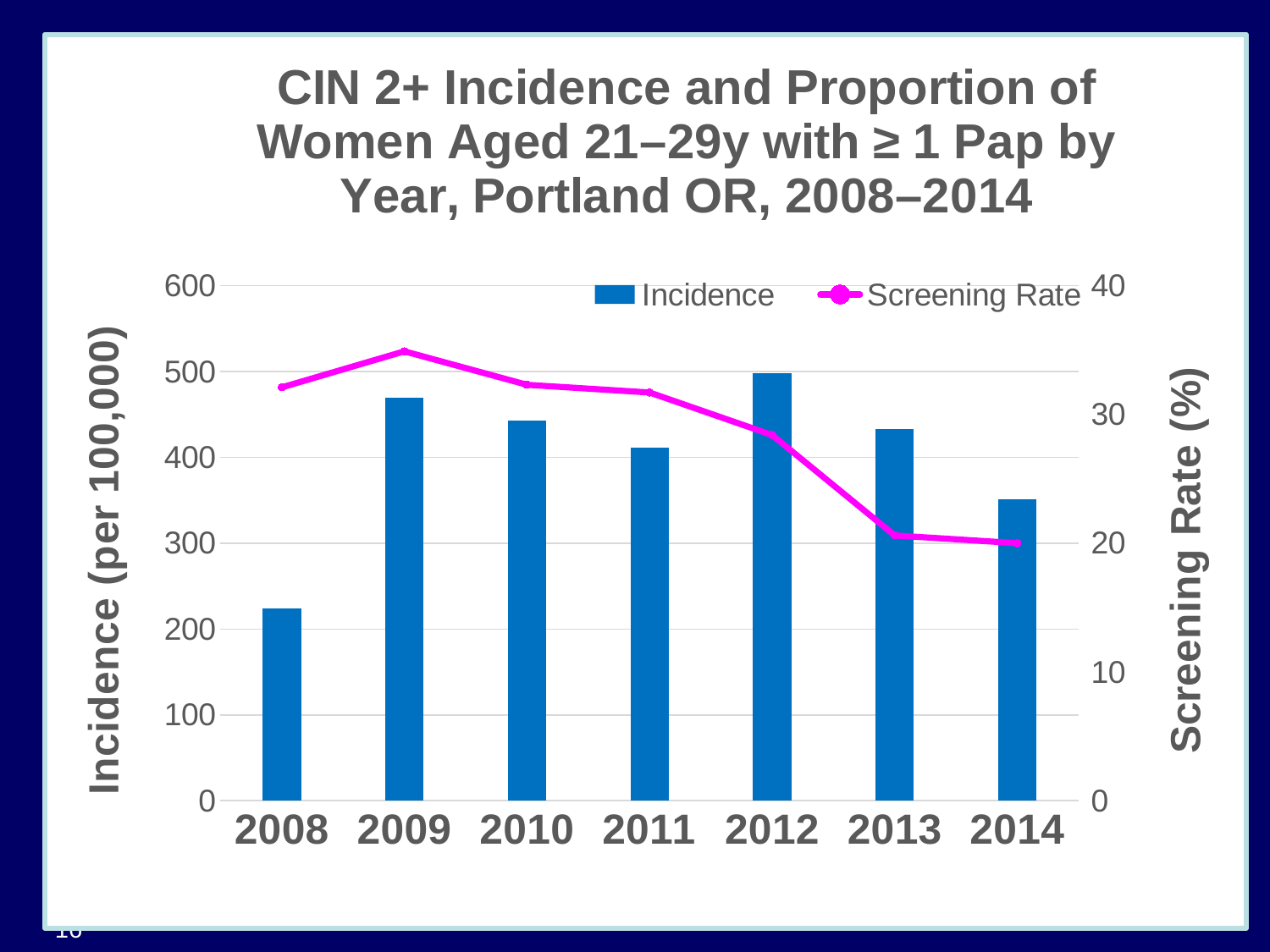
Which year has the larger Incidence value, 2009 or 2011? 2009 Which year has the lowest Incidence bar? 2008 Is the Screening Rate for 2013 greater or less than 30? less Does the Screening Rate rise or fall from 2011 to 2014? It falls What kind of chart is shown on the slide? A combined bar and line chart How many series does the legend list? 2 Which year has the highest Incidence bar? 2012 Is the Incidence value for 2008 greater or less than 300? less In which year is the Screening Rate highest? 2009 What is the label on the right-hand vertical axis? Screening Rate (%) Is the Incidence value for 2012 greater or less than 400? greater How many years are shown on the x axis? 7